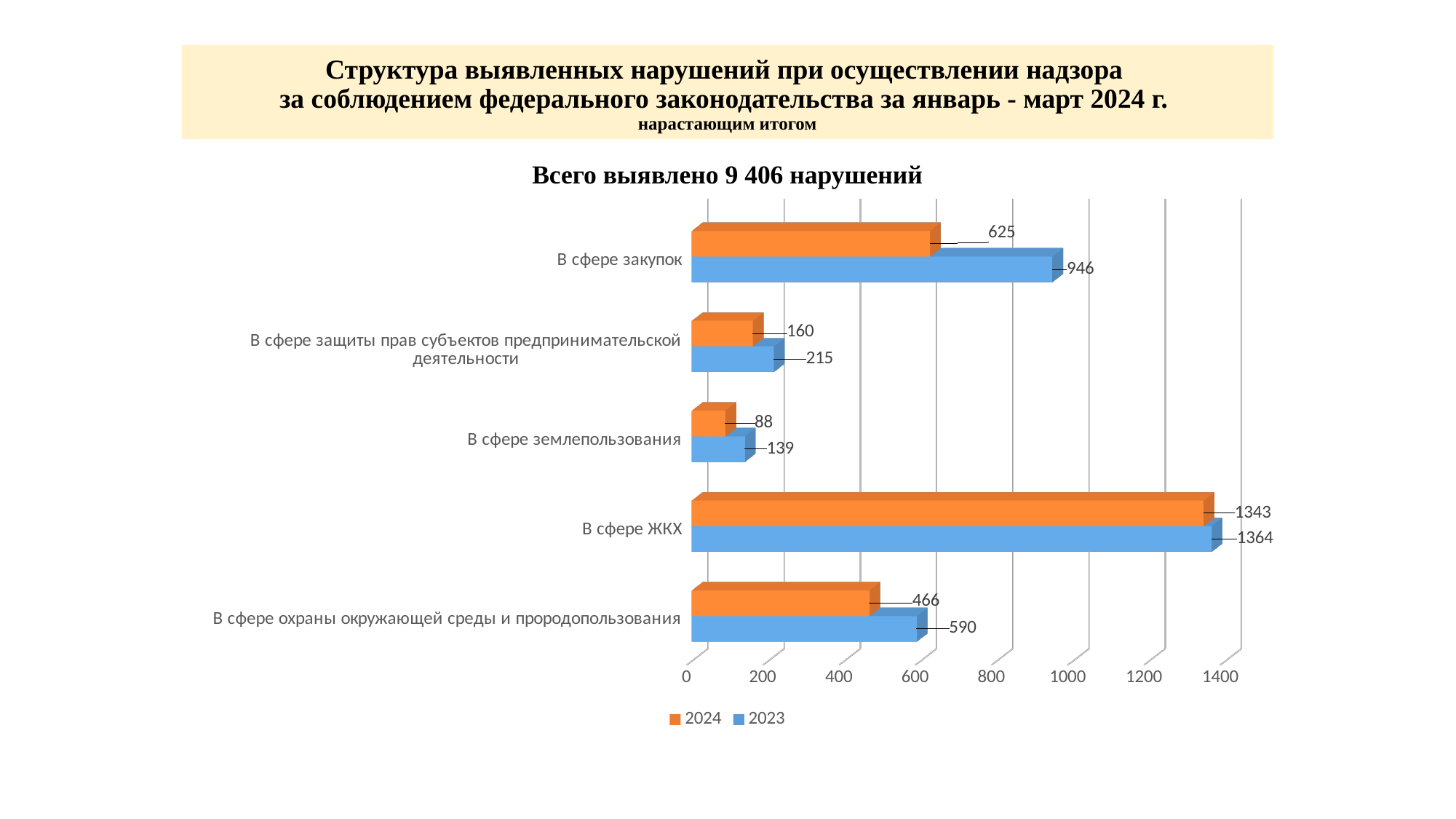
How many series does the legend list? 2 What kind of chart is shown on the slide? Bar chart Which category has the highest 2024 value? В сфере ЖКХ How many categories are shown on the chart? 5 What is the difference between the 2023 and 2024 values for «В сфере закупок»? 321 Which is larger for «В сфере защиты прав субъектов предпринимательской деятельности»: the 2024 value or the 2023 value? 2023 Which category has the lowest 2023 value? В сфере землепользования What is the 2023 value for «В сфере охраны окружающей среды и прородопользования»? 590 What is the 2023 value for «В сфере ЖКХ»? 1364 What is the 2024 value for «В сфере землепользования»? 88 What total number of violations is stated above the chart? 9 406 What is the 2024 value for «В сфере закупок»? 625